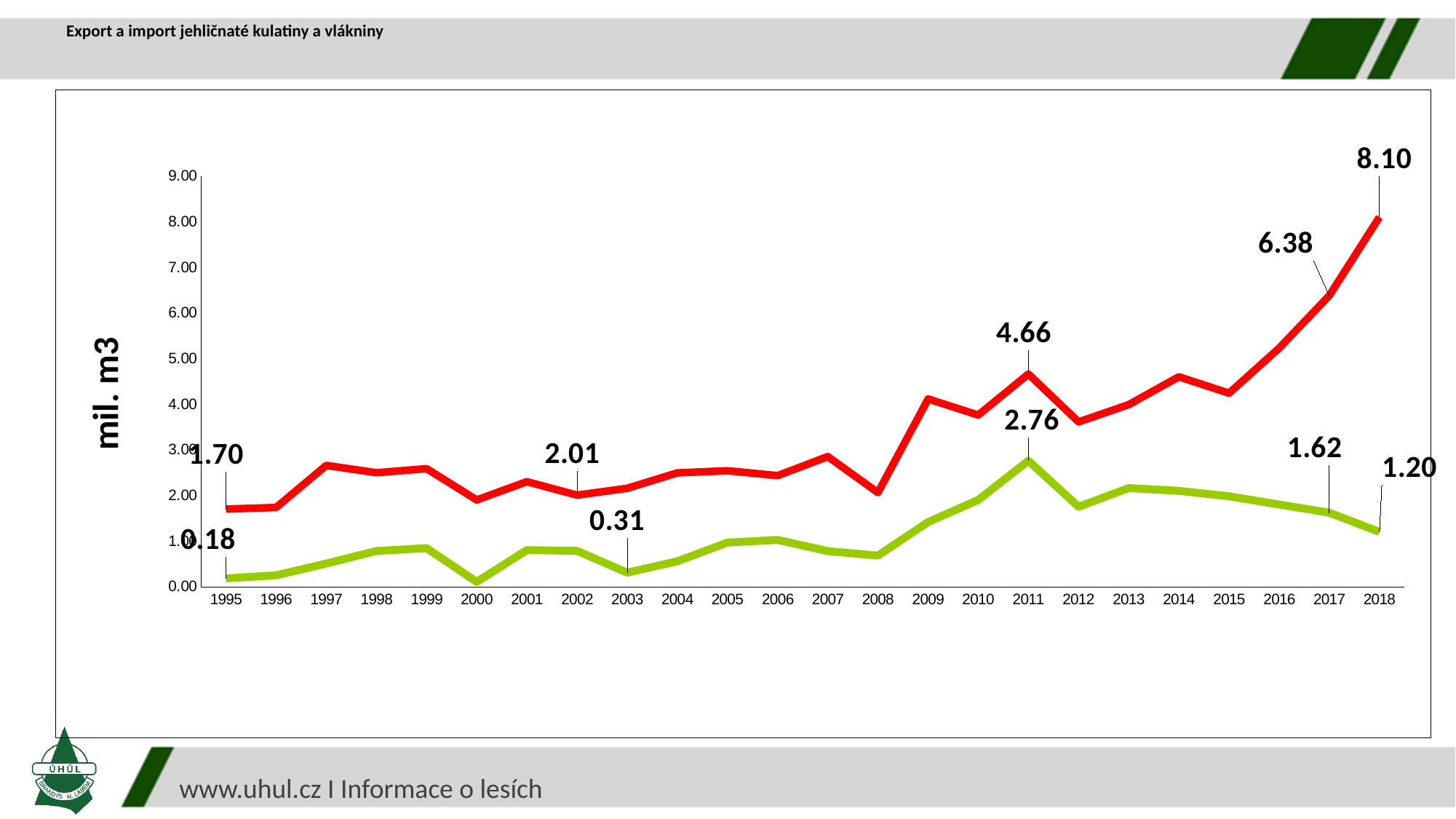
What is the value of the green line in 1995? 0.18 Is the value of the green line in 2000 greater or less than 1.00? less How many years are shown on the x axis? 24 What is the value of the red line in 2018? 8.10 What is the value of the green line in 2017? 1.62 Which is larger in 2011, the red line value or the green line value? red line By how much did the red line increase from 2017 to 2018? 1.72 What is the label of the vertical axis? mil. m3 What is the difference between the red line and the green line in 2018? 6.90 What is the value of the red line in 2011? 4.66 What type of chart is shown on the slide? line chart Is the value of the red line in 2009 greater or less than 3.00? greater